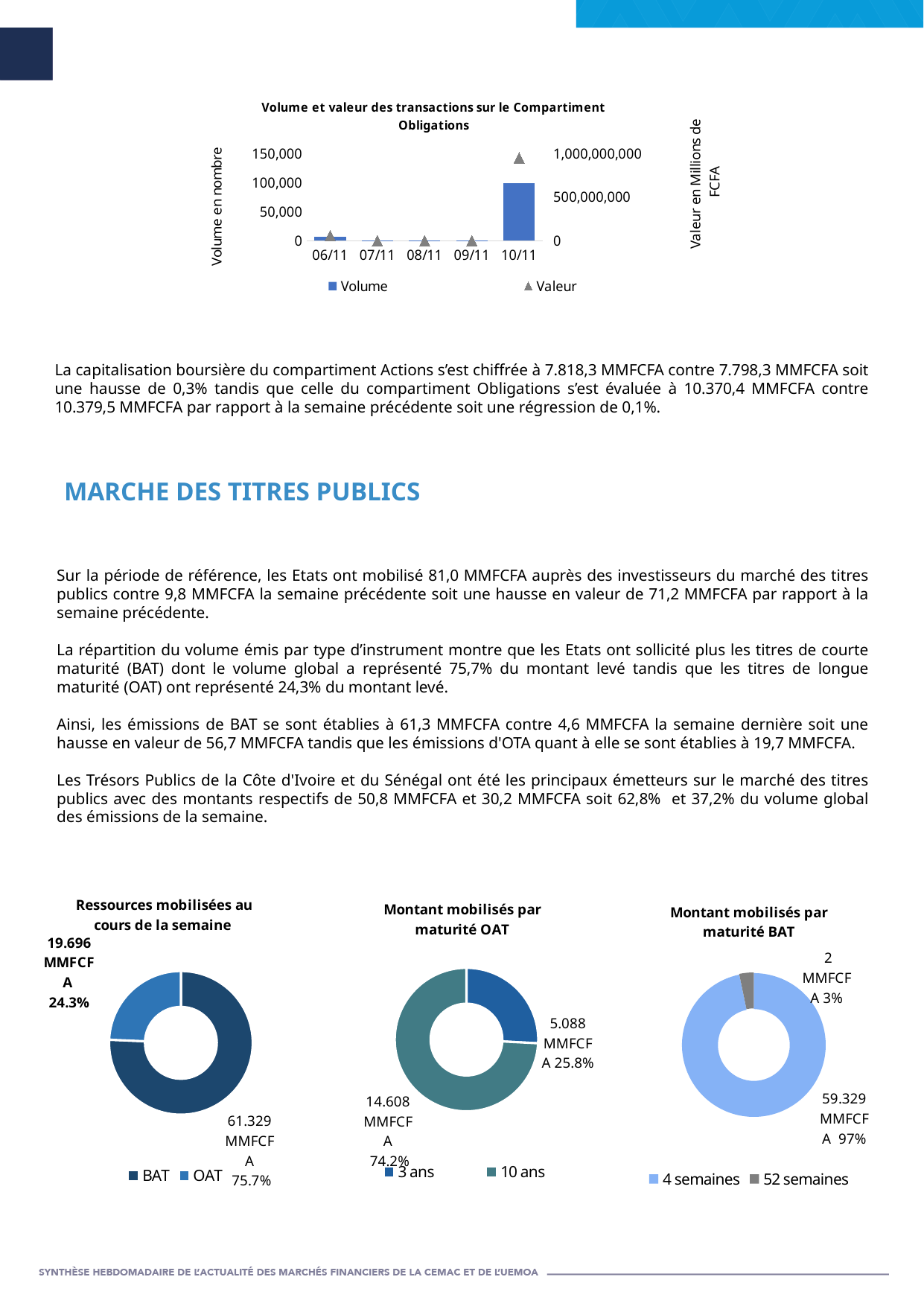
In the chart 'Ressources mobilisées au cours de la semaine', what is the value for OAT? 19.696 MMFCFA In the chart 'Montant mobilisés par maturité BAT', what is the value for 4 semaines? 59.329 MMFCFA In the chart 'Volume et valeur des transactions sur le Compartiment Obligations', which date has the highest Volume? 10/11 In the chart 'Montant mobilisés par maturité OAT', what is the value for 10 ans? 14.608 MMFCFA In the chart 'Volume et valeur des transactions sur le Compartiment Obligations', how many dates are shown on the x axis? 5 In the chart 'Montant mobilisés par maturité BAT', what share does 52 semaines represent? 3% What kind of chart is 'Volume et valeur des transactions sur le Compartiment Obligations'? Bar chart combined with a line/marker series In the chart 'Volume et valeur des transactions sur le Compartiment Obligations', how many series does the legend list? 2 In the chart 'Volume et valeur des transactions sur le Compartiment Obligations', is the Valeur for 10/11 greater or less than 500,000,000? greater In the chart 'Ressources mobilisées au cours de la semaine', what share does BAT represent? 75.7% In the chart 'Montant mobilisés par maturité OAT', which maturity has the smallest share? 3 ans In the chart 'Volume et valeur des transactions sur le Compartiment Obligations', is the Volume for 10/11 greater or less than 50,000? greater